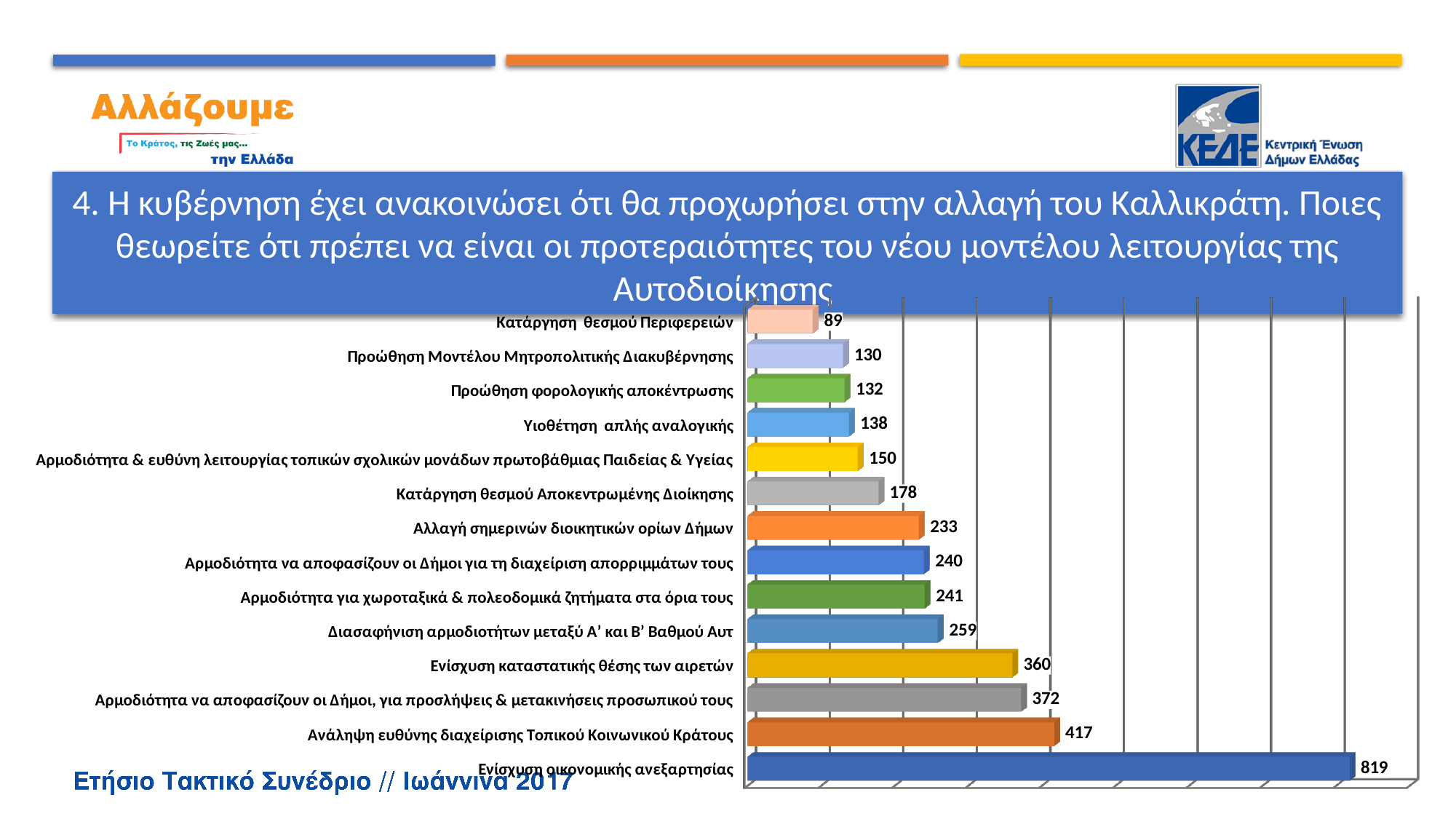
What value is shown for "Ενίσχυση καταστατικής θέσης των αιρετών"? 360 What value is shown for "Ενίσχυση οικονομικής ανεξαρτησίας"? 819 What value is shown for "Υιοθέτηση απλής αναλογικής"? 138 What is the difference between the values for "Ενίσχυση οικονομικής ανεξαρτησίας" and "Κατάργηση θεσμού Περιφερειών"? 730 What is the difference between the values for "Ανάληψη ευθύνης διαχείρισης Τοπικού Κοινωνικού Κράτους" and "Αρμοδιότητα να αποφασίζουν οι Δήμοι, για προσλήψεις & μετακινήσεις προσωπικού τους"? 45 What value is shown for "Κατάργηση θεσμού Αποκεντρωμένης Διοίκησης"? 178 What value is shown for "Αρμοδιότητα για χωροταξικά & πολεοδομικά ζητήματα στα όρια τους"? 241 Which category has the highest value? Ενίσχυση οικονομικής ανεξαρτησίας How many categories are shown in the chart? 14 What kind of chart is shown on the slide? Bar chart Which is larger: the value for "Αλλαγή σημερινών διοικητικών ορίων Δήμων" or the value for "Διασαφήνιση αρμοδιοτήτων μεταξύ Α' και Β' Βαθμού Αυτ"? Διασαφήνιση αρμοδιοτήτων μεταξύ Α' και Β' Βαθμού Αυτ Which category has the lowest value? Κατάργηση θεσμού Περιφερειών